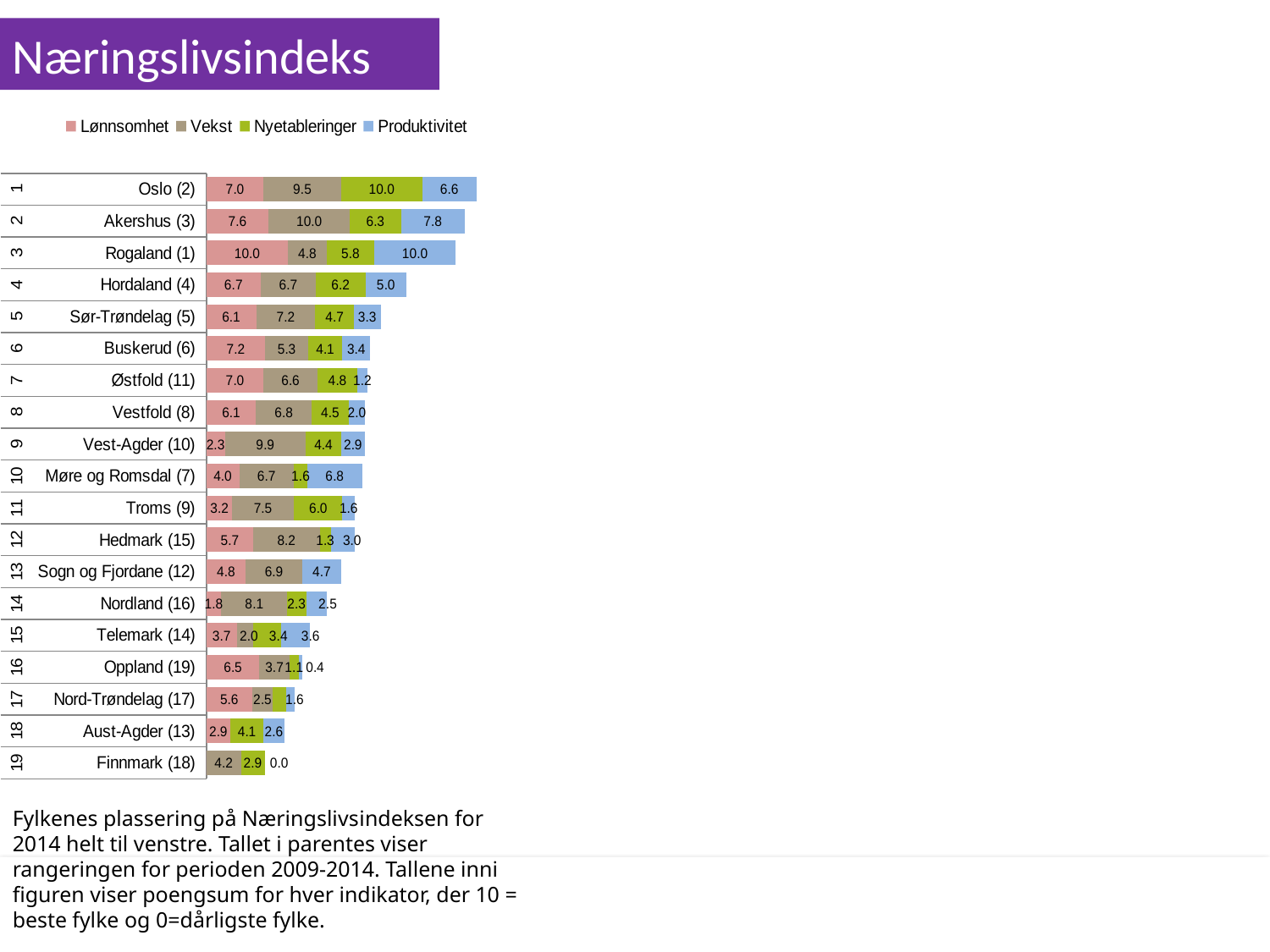
What is the Produktivitet value for Oppland (19)? 0.4 How many counties are shown in the chart? 19 Which county has the highest Lønnsomhet value? Rogaland (1) What is the Produktivitet value for Finnmark (18)? 0.0 What kind of chart is shown on the slide? Stacked bar chart What is the difference between the Lønnsomhet values of Rogaland (1) and Vest-Agder (10)? 7.7 What is the Vekst value for Akershus (3)? 10.0 What is the Nyetableringer value for Oslo (2)? 10.0 Which has the larger Produktivitet value, Oslo (2) or Akershus (3)? Akershus (3) How many series does the legend list? 4 What is the total of the stacked bar for Oslo (2)? 33.1 What is the Vekst value for Vest-Agder (10)? 9.9